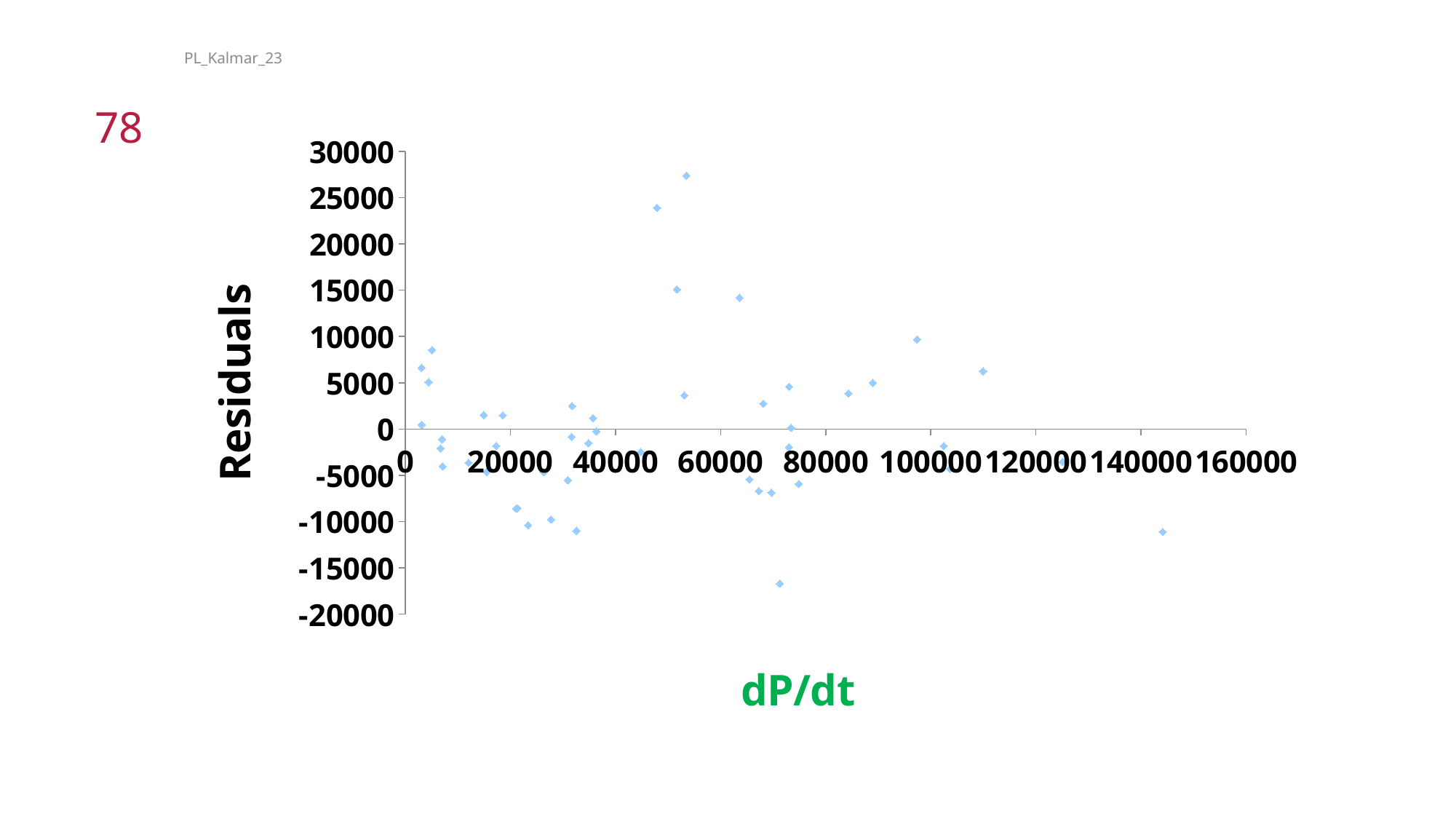
Is the residual of the lowest point on the chart greater or less than -15000? less Is the dP/dt value of the highest residual point greater or less than 60000? less What is the label of the vertical axis? Residuals What is the highest tick value shown on the vertical axis? 30000 Is the dP/dt value of the lowest residual point greater or less than 60000? greater What is the label of the horizontal axis? dP/dt How many points have a dP/dt value greater than 140000? 1 What kind of chart is shown on the slide? scatter plot